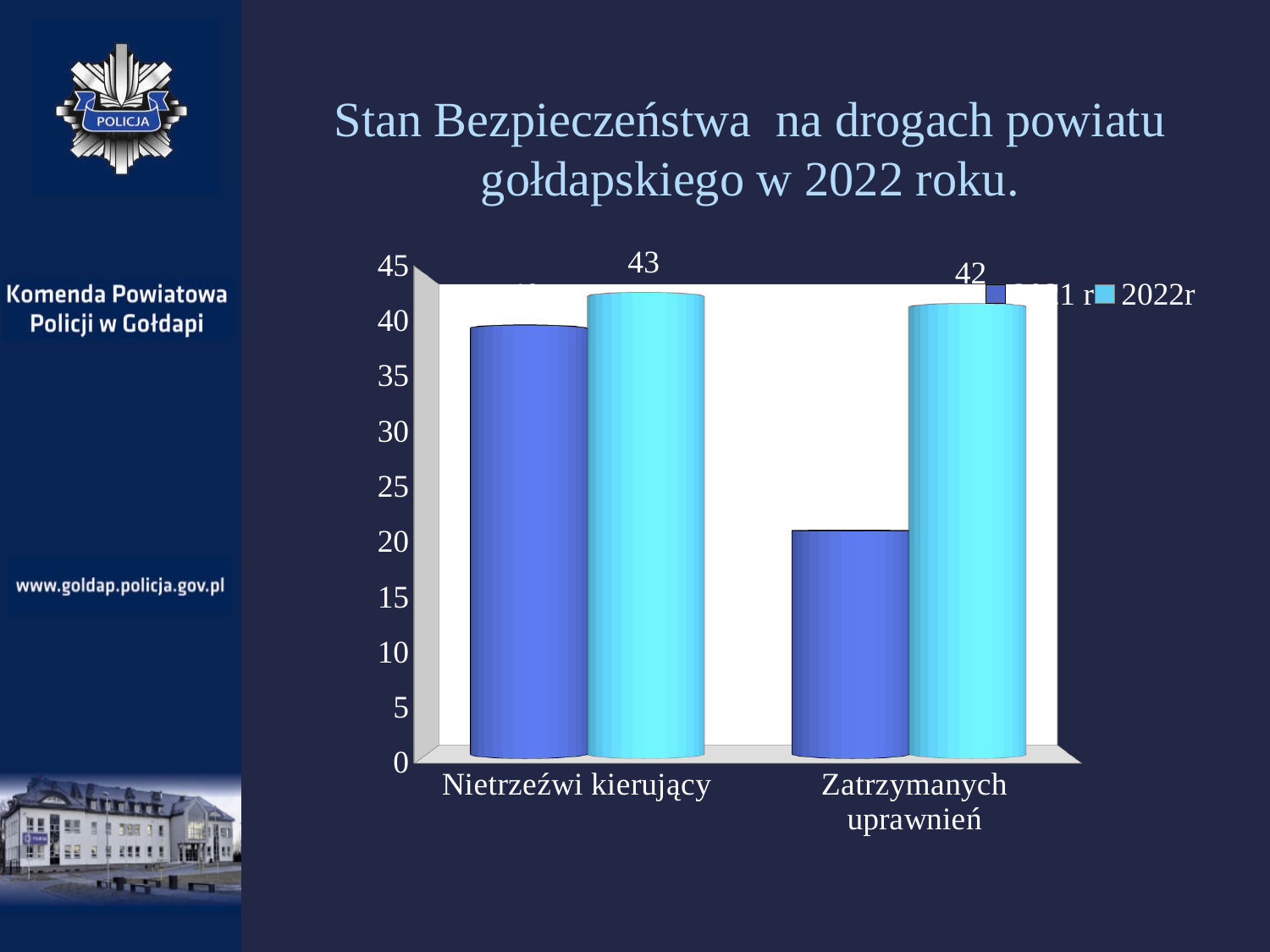
What kind of chart is shown on the slide? bar chart How many categories are shown on the x axis of the chart? 2 What is the 2022r value for Zatrzymanych uprawnień? 42 What is the title of the slide containing the chart? Stan Bezpieczeństwa na drogach powiatu gołdapskiego w 2022 roku. What is the difference between the 2022r values for Nietrzeźwi kierujący and Zatrzymanych uprawnień? 1 Which category has the higher 2022r value, Nietrzeźwi kierujący or Zatrzymanych uprawnień? Nietrzeźwi kierujący Which category has the highest 2022r value? Nietrzeźwi kierujący For Nietrzeźwi kierujący, is the dark blue bar greater or less than 35? greater For Zatrzymanych uprawnień, which bar is taller, the dark blue bar or the 2022r bar? 2022r What is the 2022r value for Nietrzeźwi kierujący? 43 How many series does the chart's legend list? 2 For Zatrzymanych uprawnień, is the dark blue bar greater or less than 25? less